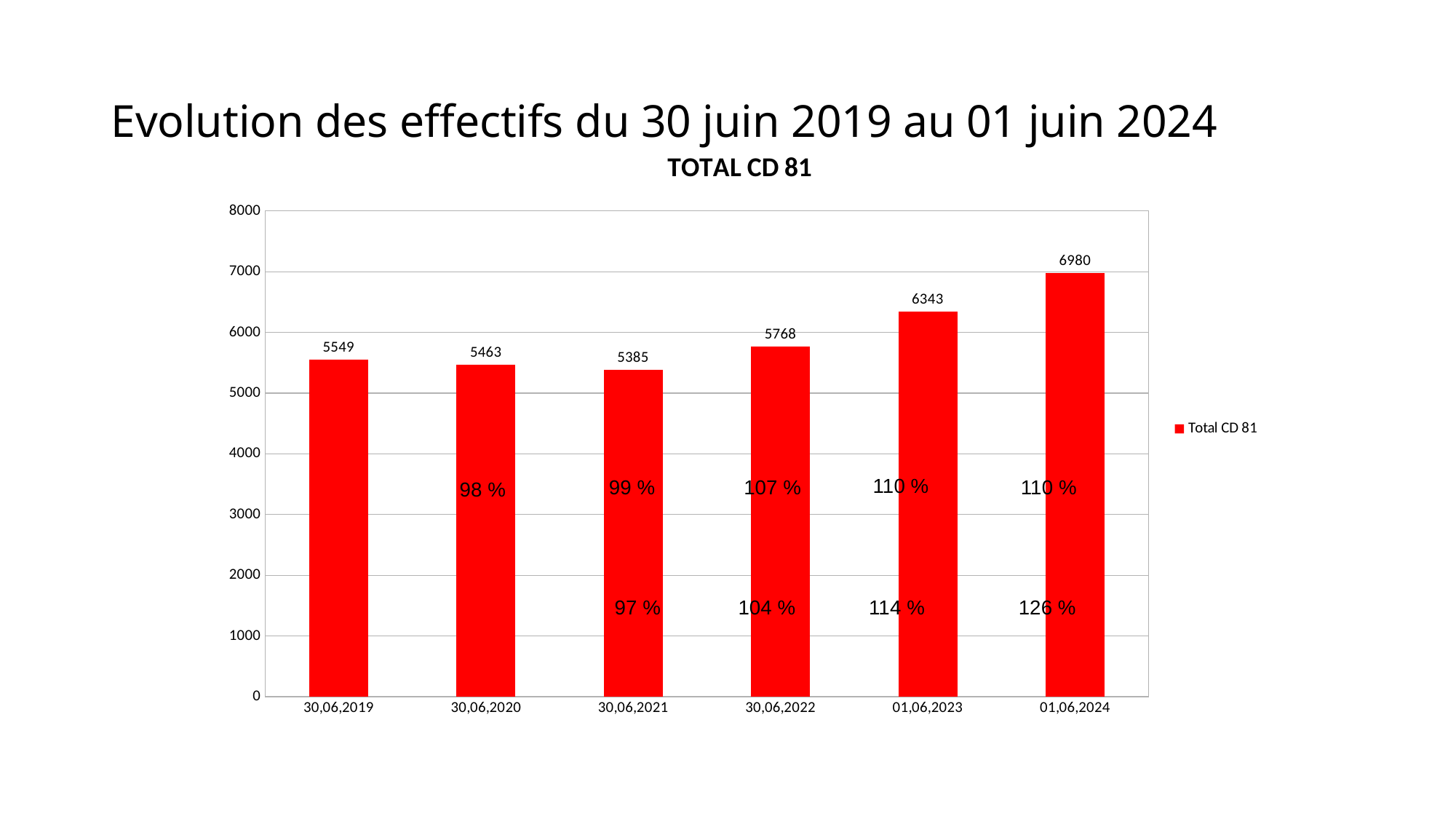
What kind of chart is shown? bar chart What is the difference between the values for 01,06,2024 and 01,06,2023? 637 How many series does the legend list? 1 What is the value for 30,06,2019? 5549 Which is larger, the value for 30,06,2020 or the value for 30,06,2022? 30,06,2022 Which date has the lowest value? 30,06,2021 What is the difference between the values for 30,06,2019 and 30,06,2021? 164 Which date has the highest value? 01,06,2024 How many bars are shown in the chart? 6 What is the value for 01,06,2024? 6980 What is the title of the chart? TOTAL CD 81 What is the value for 30,06,2022? 5768